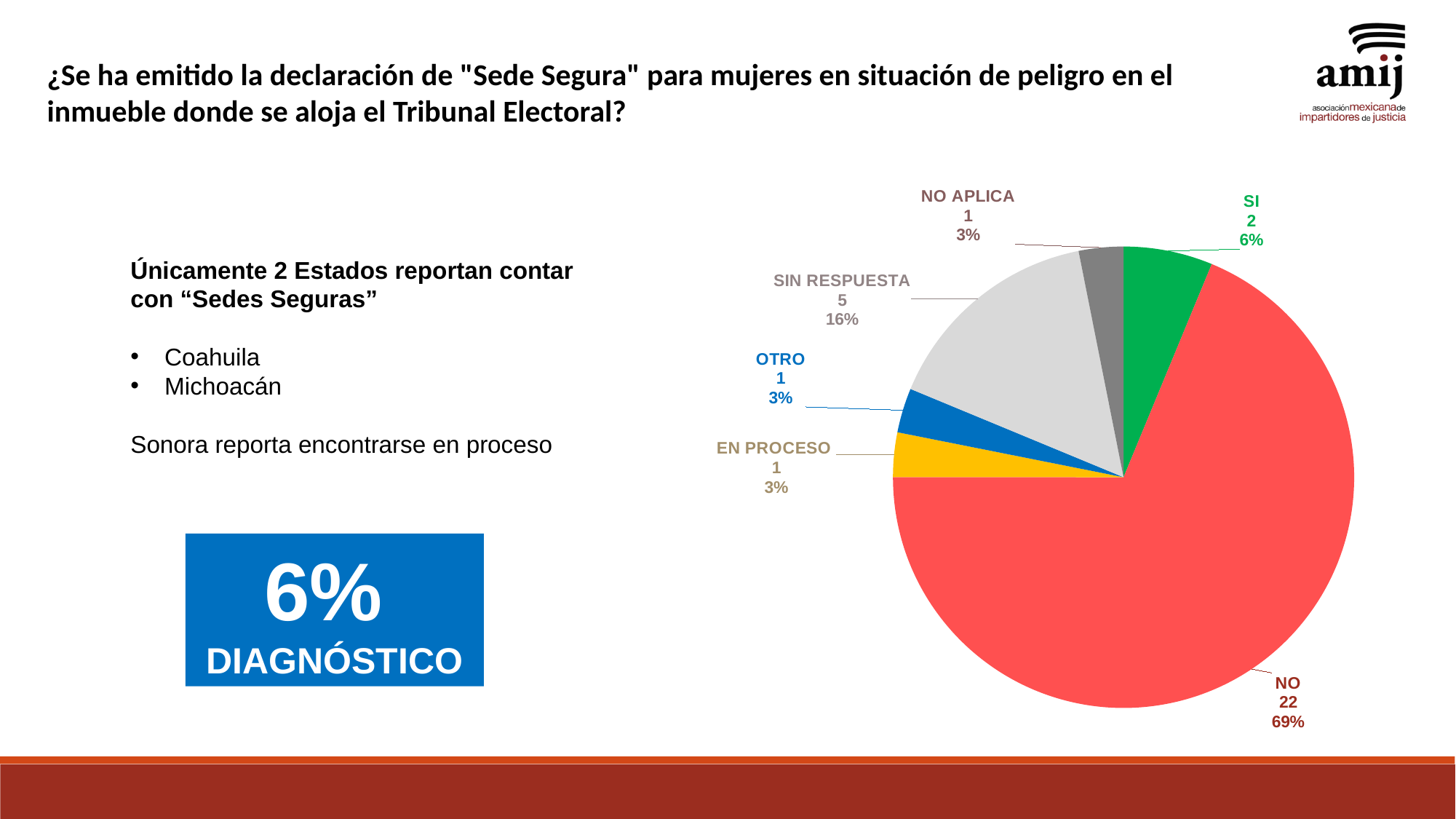
What kind of chart is shown on the slide? pie chart Which category has the largest slice of the pie? NO What is the count shown for the NO slice? 22 What colour is the NO slice of the pie chart? red What is the total count across all slices of the pie chart? 32 What is the difference in count between the NO slice and the SIN RESPUESTA slice? 17 Which slice is larger, SI or SIN RESPUESTA? SIN RESPUESTA How many slices does the pie chart have? 6 What percentage is shown for the SIN RESPUESTA slice? 16% What is the count shown for the SI slice? 2 What share of the pie does the NO slice represent? 69% What percentage is shown for the NO APLICA slice? 3%